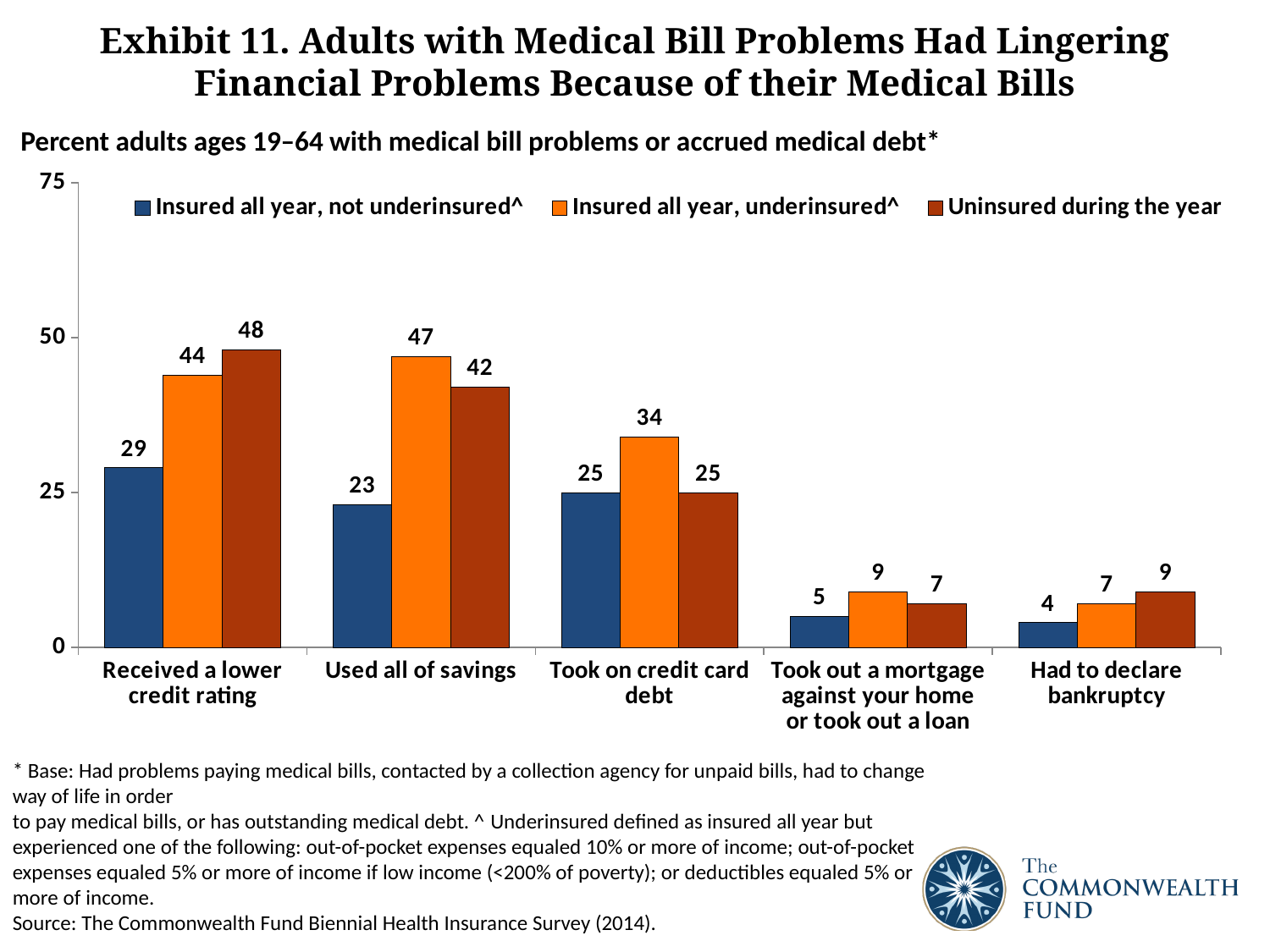
Which category has the lowest value for the 'Uninsured during the year' series? Took out a mortgage against your home or took out a loan In the 'Used all of savings' category, which is larger: the 'Insured all year, underinsured^' value or the 'Uninsured during the year' value? Insured all year, underinsured^ What is the maximum value shown on the y axis? 75 Is the value for 'Insured all year, underinsured^' in the 'Took on credit card debt' category greater or less than 25? greater What is the difference between the 'Insured all year, underinsured^' and 'Insured all year, not underinsured^' values in the 'Used all of savings' category? 24 What is the value for 'Insured all year, not underinsured^' in the 'Took out a mortgage against your home or took out a loan' category? 5 What is the value for 'Uninsured during the year' in the 'Received a lower credit rating' category? 48 What is the value for 'Insured all year, underinsured^' in the 'Used all of savings' category? 47 How many series does the legend list? 3 How many categories are shown on the x axis? 5 Which category has the highest value for the 'Insured all year, not underinsured^' series? Received a lower credit rating What kind of chart is shown on the slide? bar chart